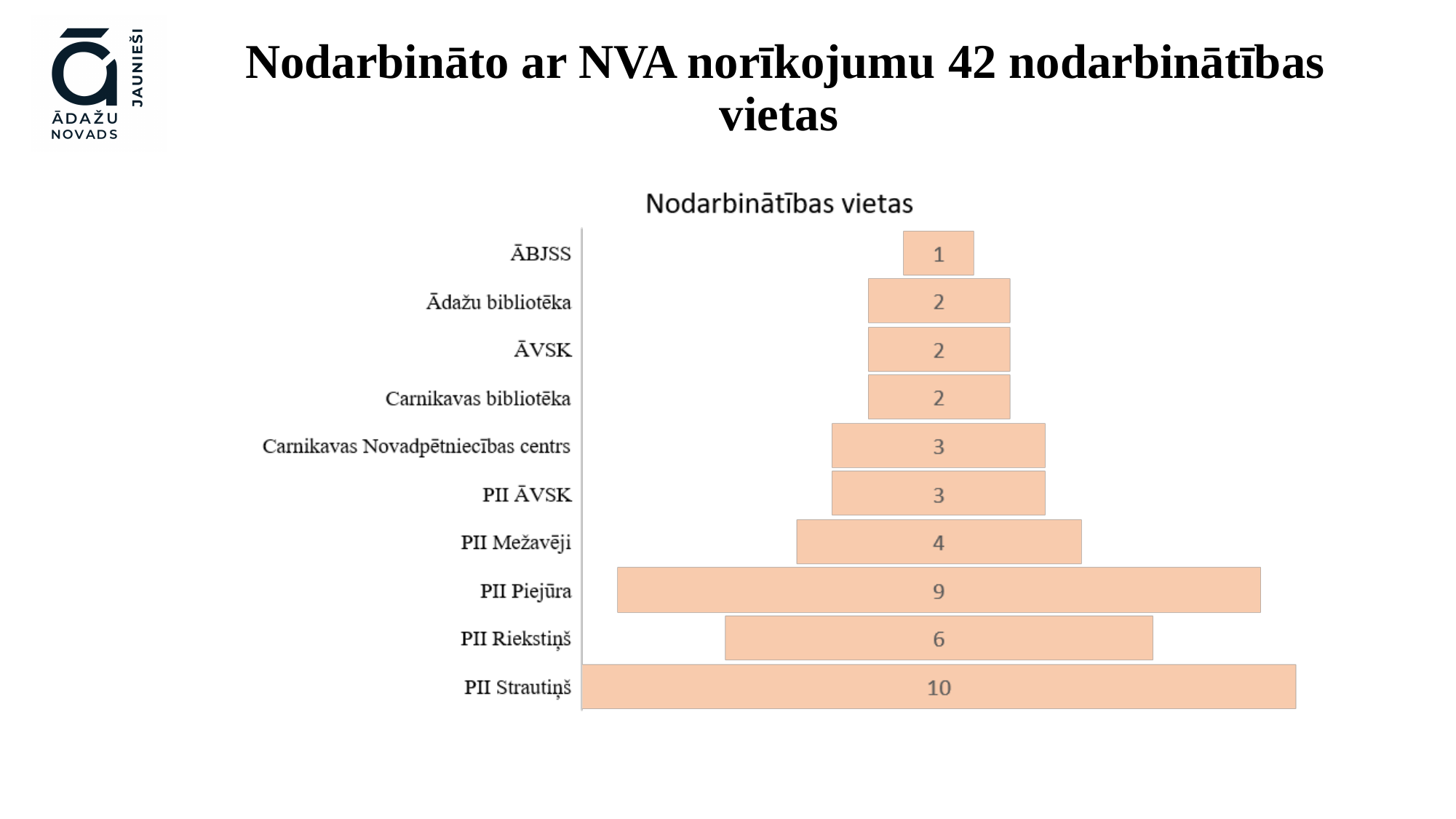
Which category has the lowest value? ĀBJSS What is the difference between the values for PII Piejūra and PII Mežavēji? 5 What is the value for PII Piejūra? 9 Which category has the highest value? PII Strautiņš How many categories are shown in the chart? 10 What is the value for ĀBJSS? 1 What kind of chart is shown on the slide? Bar chart What is the value for PII Strautiņš? 10 Which is larger, the value for PII Riekstiņš or the value for PII Mežavēji? PII Riekstiņš What is the value for Carnikavas Novadpētniecības centrs? 3 What is the difference between the values for PII Strautiņš and PII Riekstiņš? 4 What is the title of the chart? Nodarbinātības vietas